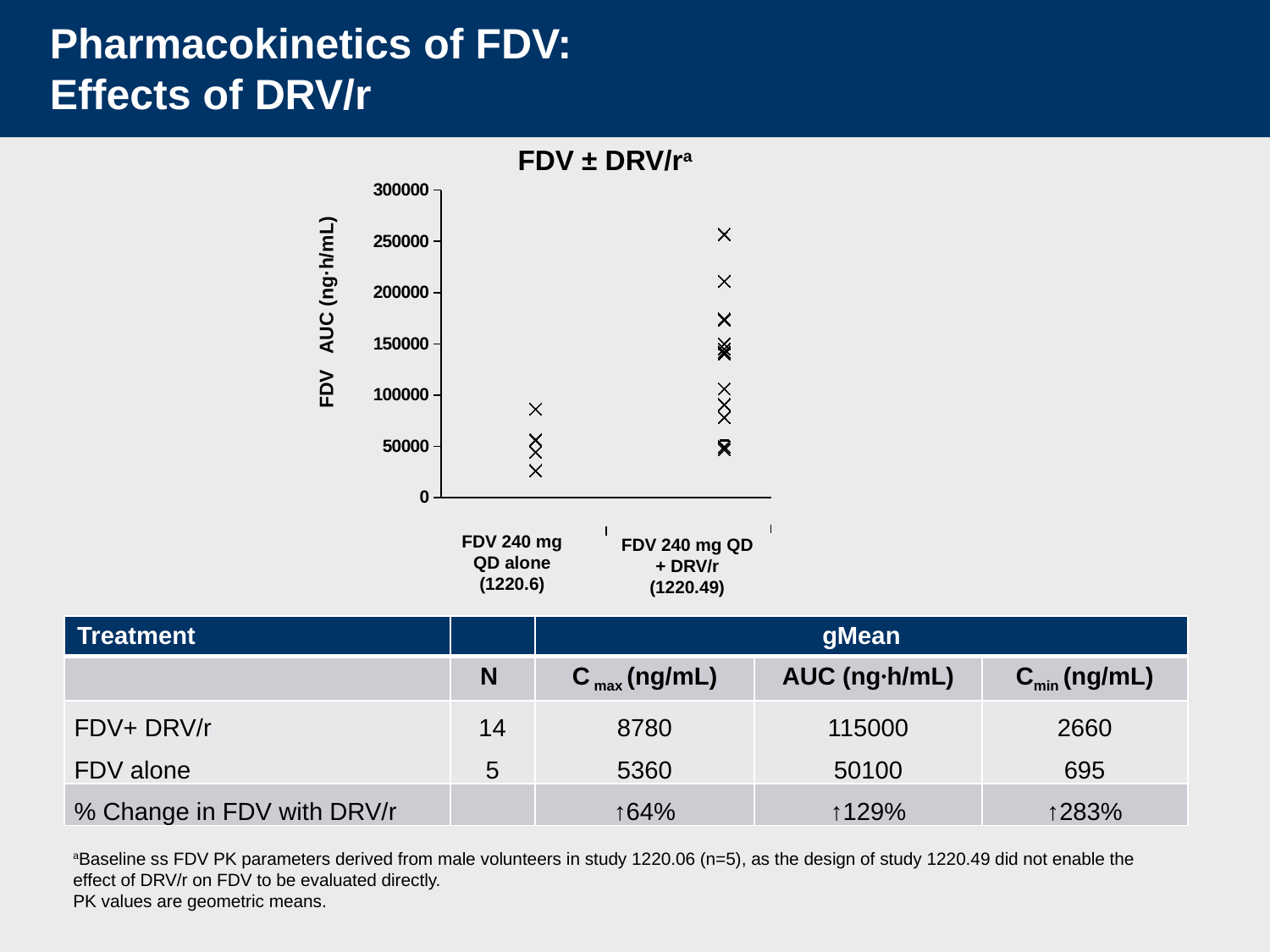
How many treatment groups are plotted along the x-axis of the chart? 2 What is the maximum value shown on the y-axis of the chart? 300000 Which group contains the highest plotted FDV AUC value? FDV 240 mg QD + DRV/r (1220.49) Is the highest plotted value for the FDV 240 mg QD alone group greater or less than 50000? greater How many data points are plotted for the FDV 240 mg QD alone (1220.6) group? 5 Which group contains the lowest plotted FDV AUC value? FDV 240 mg QD alone (1220.6) Is the highest plotted value for the FDV 240 mg QD alone group greater or less than 100000? less What is the title of the chart? FDV ± DRV/r Is the lowest plotted value for the FDV 240 mg QD alone group greater or less than 50000? less What kind of chart is shown on the slide? Scatter plot What is the label of the y-axis of the chart? FDV AUC (ng·h/mL)